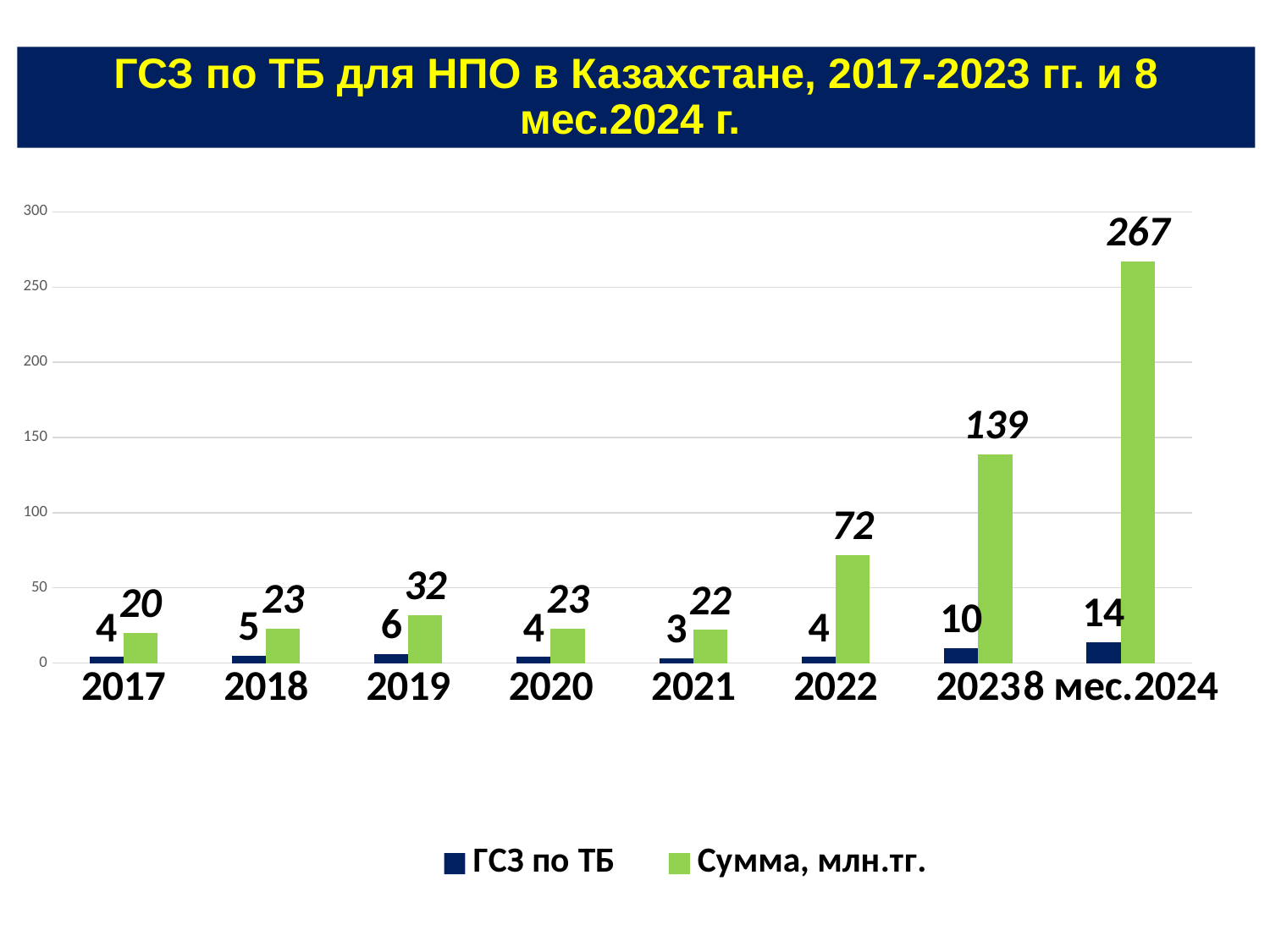
Is the "Сумма, млн.тг." value for 2023 greater or less than 100? greater What is the value of "Сумма, млн.тг." for 2022? 72 Which category has the lowest value for "ГСЗ по ТБ"? 2021 What is the difference between the "Сумма, млн.тг." values for 8 мес.2024 and 2023? 128 Which is larger: the "Сумма, млн.тг." value for 2019 or for 2021? 2019 What is the value of "ГСЗ по ТБ" for 2023? 10 What kind of chart is shown on the slide? bar chart What is the value of "Сумма, млн.тг." for 8 мес.2024? 267 How many categories are shown on the x axis? 8 How many series does the legend list? 2 Which category has the highest value for "Сумма, млн.тг."? 8 мес.2024 Which colour represents the "Сумма, млн.тг." series? green